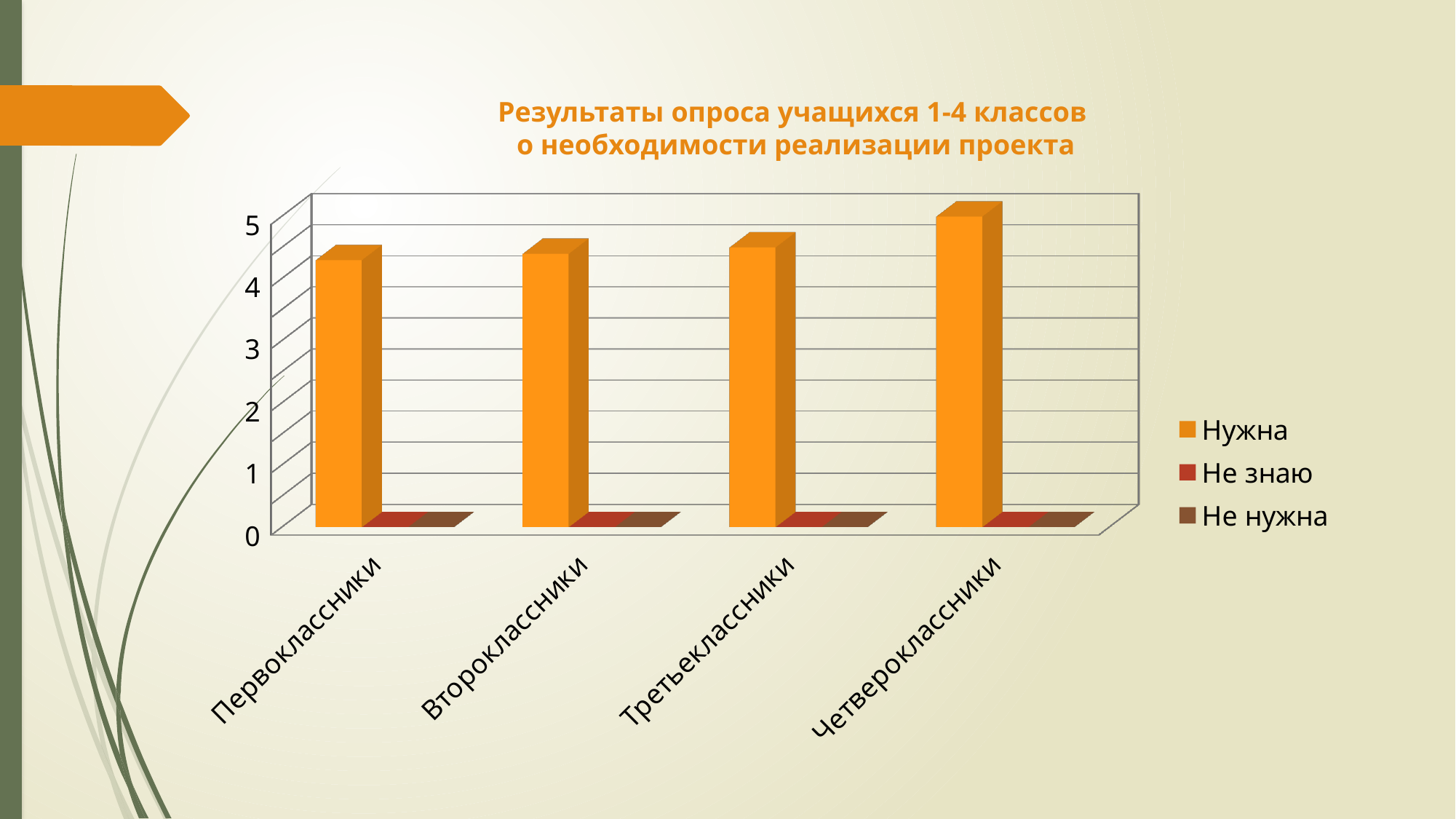
Do the values for the series Нужна rise or fall from Первоклассники to Четвероклассники? rise What is the title of the chart? Результаты опроса учащихся 1-4 классов о необходимости реализации проекта How many series does the chart's legend list? 3 How many categories are shown on the x axis of the chart? 4 Is the value for Не знаю for Второклассники greater or less than 1? less Which category has the highest value for the series Нужна? Четвероклассники For the series Нужна, which is larger: Четвероклассники or Первоклассники? Четвероклассники Is the value for Нужна for Четвероклассники greater or less than 4? greater Is the value for Не нужна for Третьеклассники greater or less than 1? less Which series is shown in orange in the chart's legend? Нужна What kind of chart is shown on the slide? bar chart